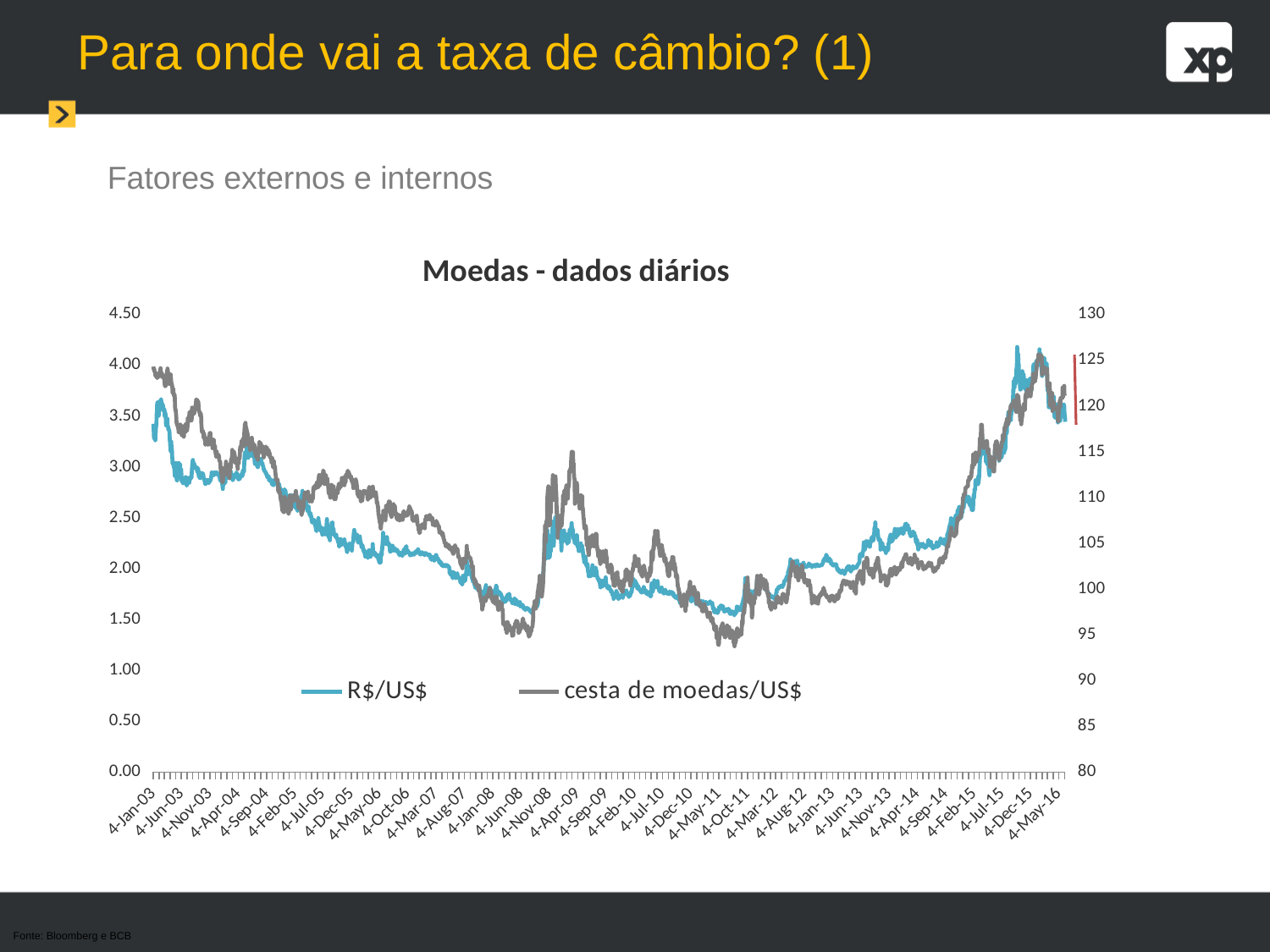
How many series does the legend of the chart list? 2 Which series is drawn in blue in the chart? R$/US$ Is the value of R$/US$ around 4-Jan-08 greater or less than 2.00? less Does the R$/US$ series rise or fall between 4-May-11 and 4-Jul-15? rise Does the cesta de moedas/US$ series rise or fall between 4-Apr-14 and 4-Dec-15? rise Does the R$/US$ series rise or fall between 4-Jan-03 and 4-Jan-08? fall Is the peak value of R$/US$ in late 2015 greater or less than 4.00? greater Is the value of cesta de moedas/US$ at 4-Jan-03 greater or less than 120 on the right axis? greater What is the title of the chart? Moedas - dados diários What kind of chart is shown on the slide? line chart